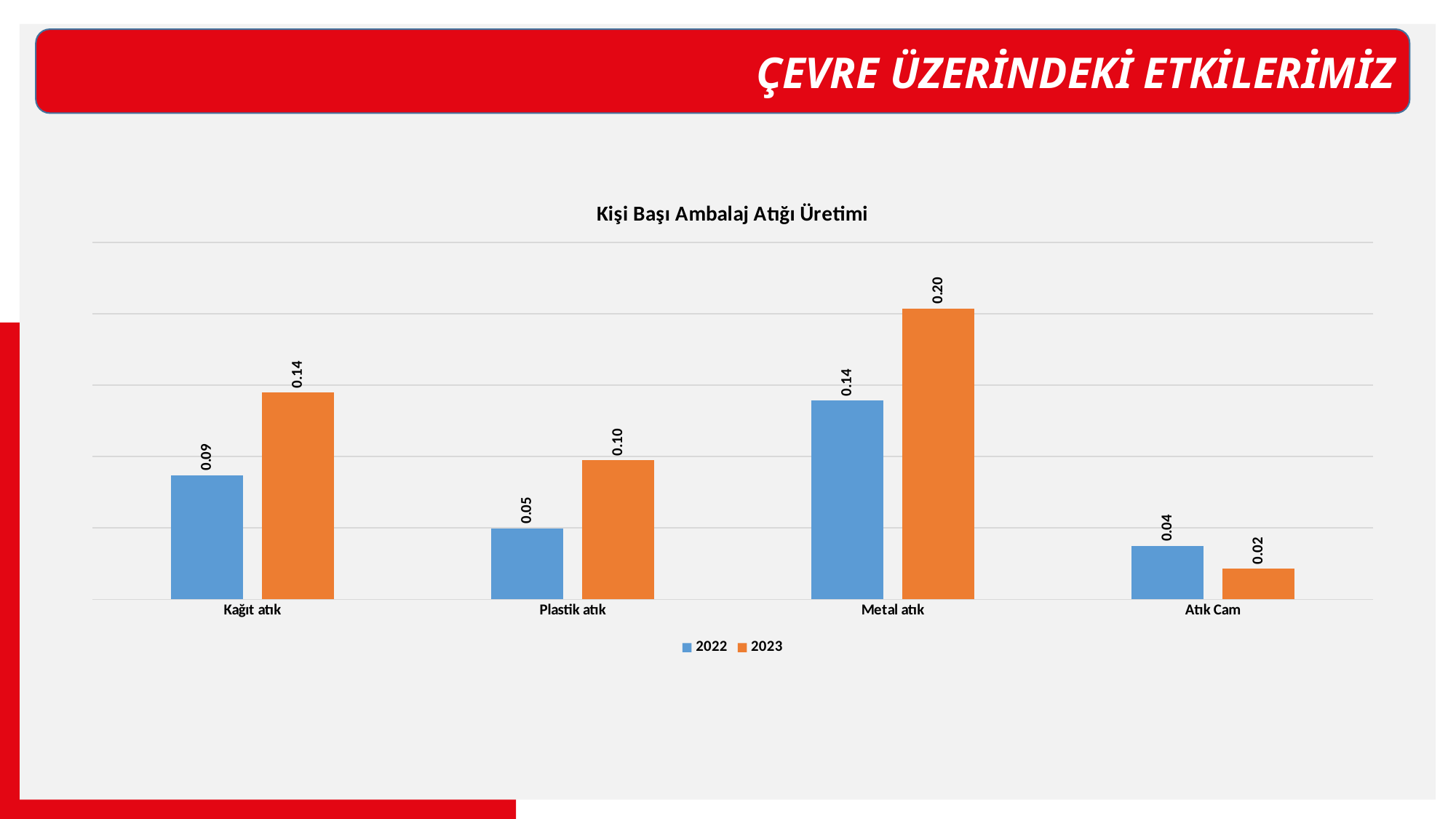
What is the title of the chart? Kişi Başı Ambalaj Atığı Üretimi What is the 2023 value for Atık Cam? 0.02 For Atık Cam, which year has the larger value, 2022 or 2023? 2022 What is the 2022 value for Kağıt atık? 0.09 How many series does the legend list? 2 Which category has the lowest 2022 value? Atık Cam What is the difference between the 2023 and 2022 values for Plastik atık? 0.05 What kind of chart is shown on the slide? Bar chart Which category has the highest 2023 value? Metal atık What is the difference between the 2023 and 2022 values for Metal atık? 0.06 What is the 2023 value for Metal atık? 0.20 How many categories are shown on the x axis? 4